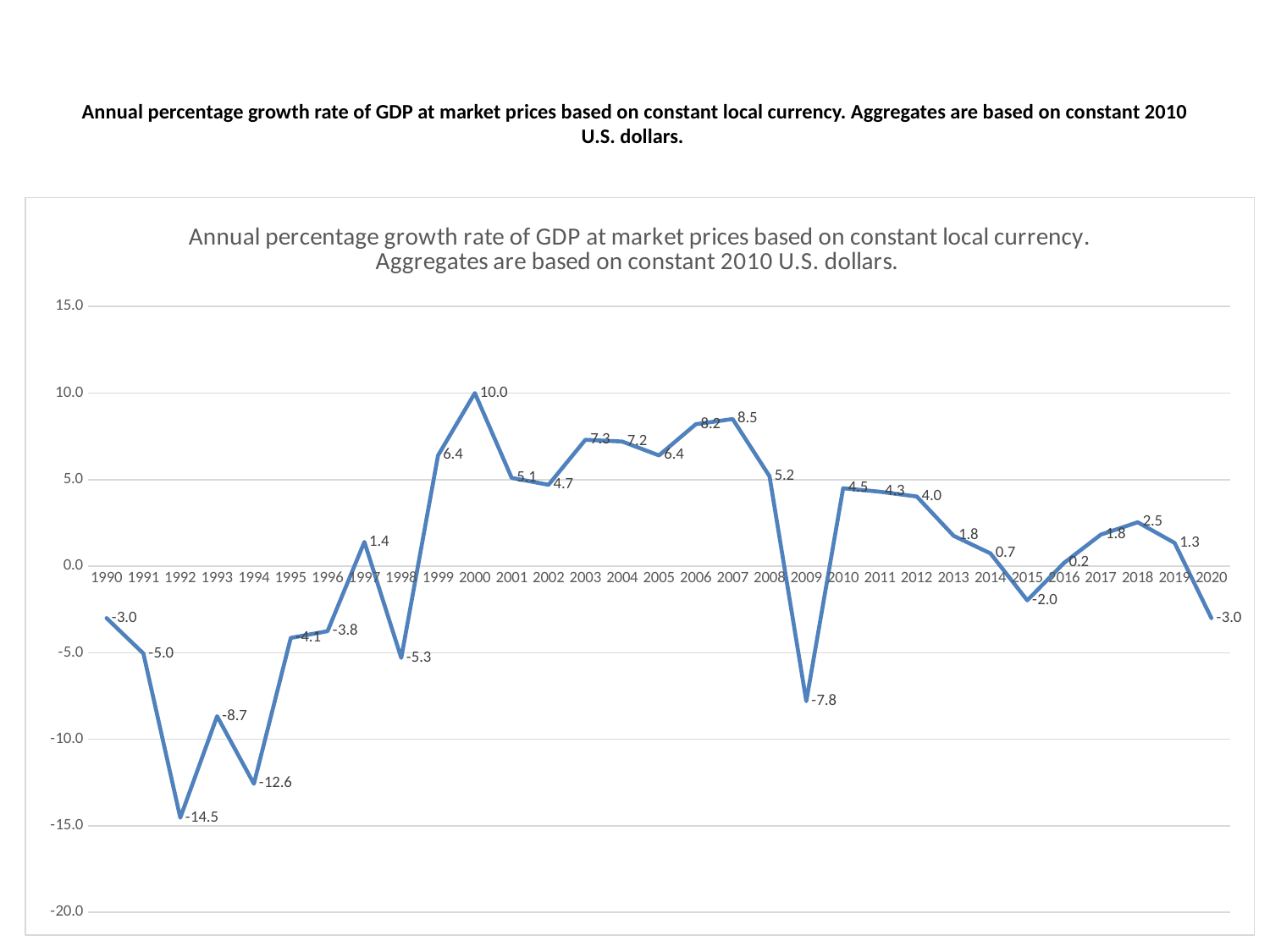
What is the value for 2000? 10.0 What is the difference between the values for 2007 and 2008? 3.3 Do the values rise or fall from 2018 to 2020? fall What is the value for 2009? -7.8 Which year has the highest value? 2000 What is the value for 2018? 2.5 What kind of chart is shown? line chart Is the value for 2006 greater or less than 5.0? greater Which is larger, the value for 1999 or the value for 2001? 1999 Which year has the lowest value? 1992 What is the value for 1992? -14.5 How many years are plotted on the chart? 31